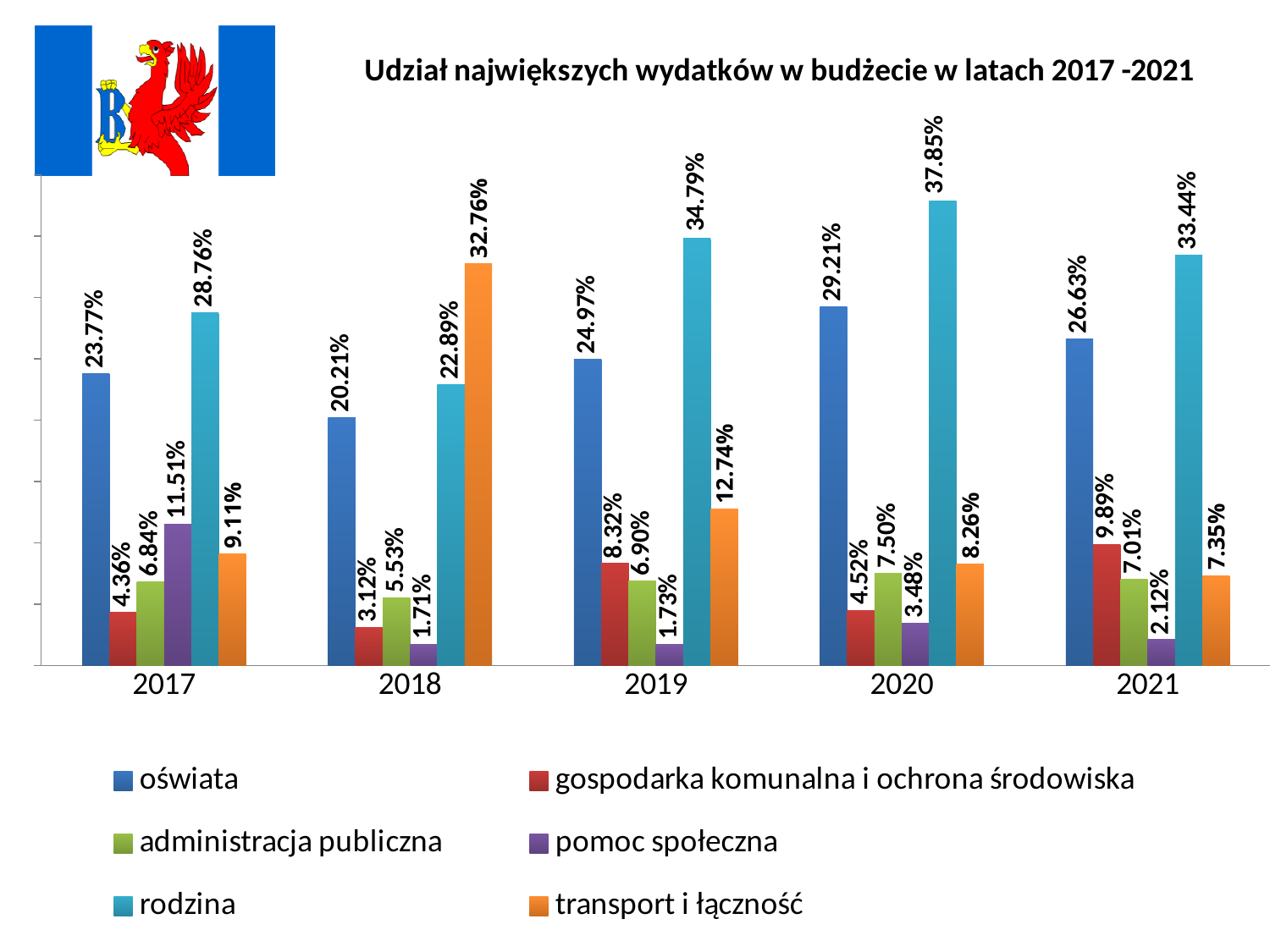
What is the value for pomoc społeczna in 2017? 11.51% What is the value for oświata in 2019? 24.97% Which is larger in 2018: the value for rodzina or the value for transport i łączność? transport i łączność What is the value for transport i łączność in 2018? 32.76% How many series does the legend list? 6 What is the title of the chart? Udział największych wydatków w budżecie w latach 2017 -2021 In which year is the value for oświata the lowest? 2018 How many years are shown on the x axis? 5 What kind of chart is shown on the slide? bar chart What is the value for gospodarka komunalna i ochrona środowiska in 2021? 9.89% What is the difference between the rodzina value and the oświata value in 2020? 8.64% In which year is the value for rodzina the highest? 2020